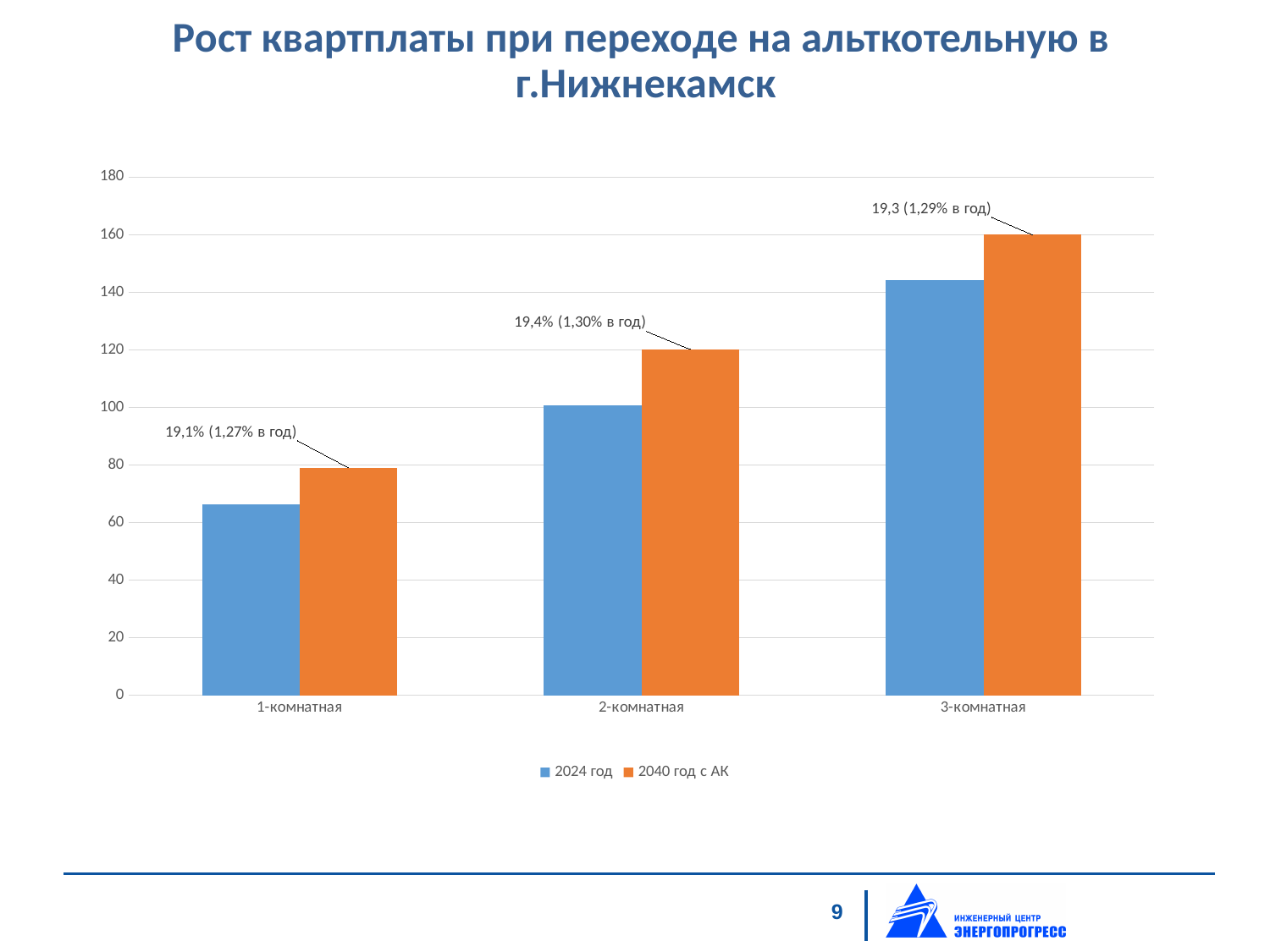
Which category has the highest value for the 2040 год с АК series? 3-комнатная What are the two series listed in the chart legend? 2024 год and 2040 год с АК What kind of chart is shown on the slide? bar chart Which is larger for 2-комнатная: the 2024 год value or the 2040 год с АК value? 2040 год с АК How many series does the chart legend list? 2 Is the 2024 год value for 1-комнатная greater or less than 80? less Is the 2040 год с АК value for 2-комнатная greater or less than 100? greater Which category has the lowest value for the 2024 год series? 1-комнатная Is the 2040 год с АК value for 3-комнатная greater or less than 140? greater How many categories are shown on the x axis of the chart? 3 What is the title of the chart on the slide? Рост квартплаты при переходе на альткотельную в г.Нижнекамск What growth annotation is shown above the 2040 год с АК bar for 2-комнатная? 19,4% (1,30% в год)